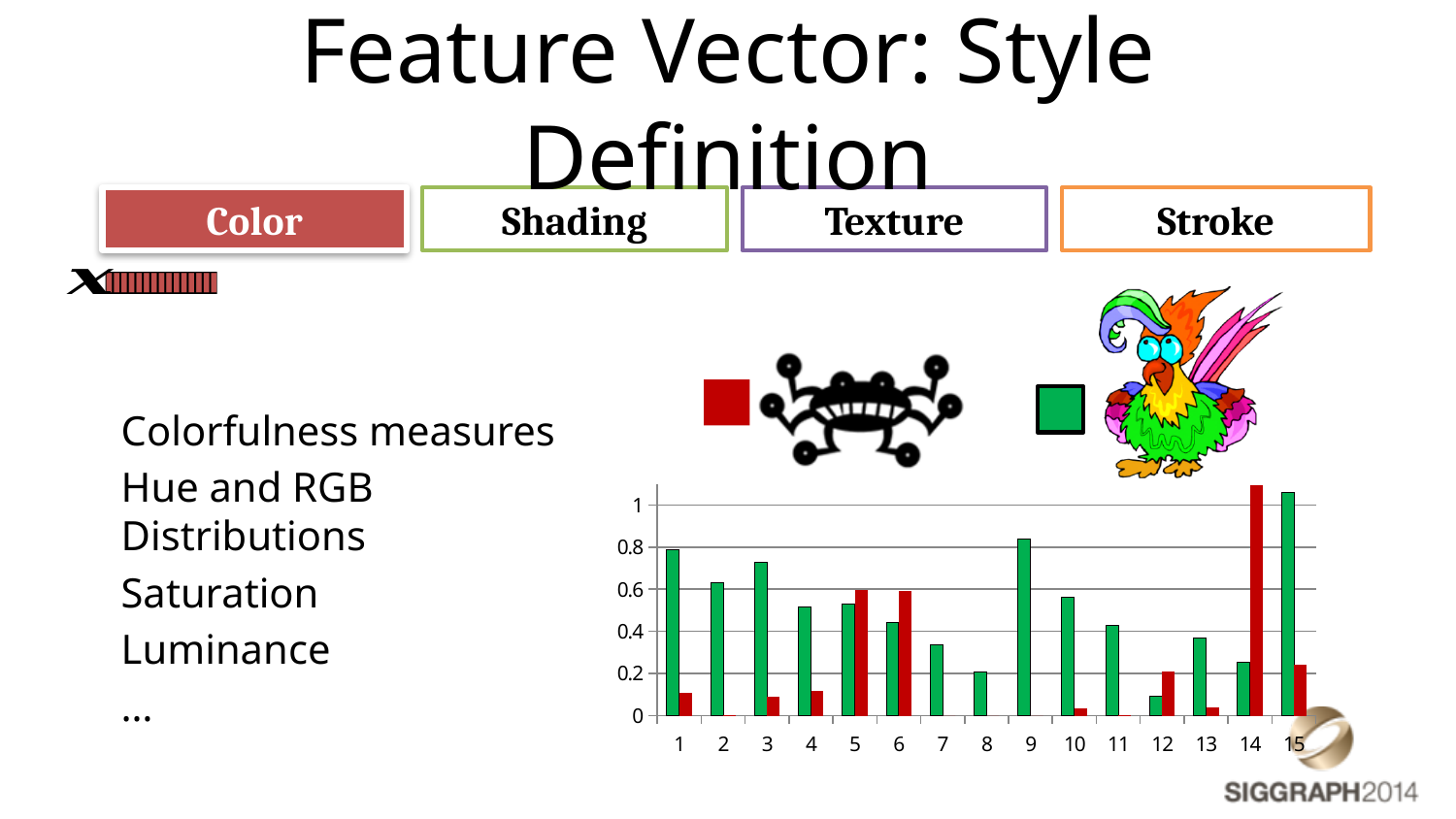
How many categories are shown along the x axis of the chart? 15 At category 1, which bar is taller, the red one or the green one? green Is the red bar for category 5 greater or less than 0.4? greater What kind of chart is shown on the slide? bar chart Is the red bar for category 14 greater or less than 1? greater Which category has the shortest green bar? 12 How many data series are plotted in the chart? 2 Is the green bar for category 8 greater or less than 0.4? less At category 14, which bar is taller, the red one or the green one? red Which category has the tallest green bar? 15 Which category has the tallest red bar? 14